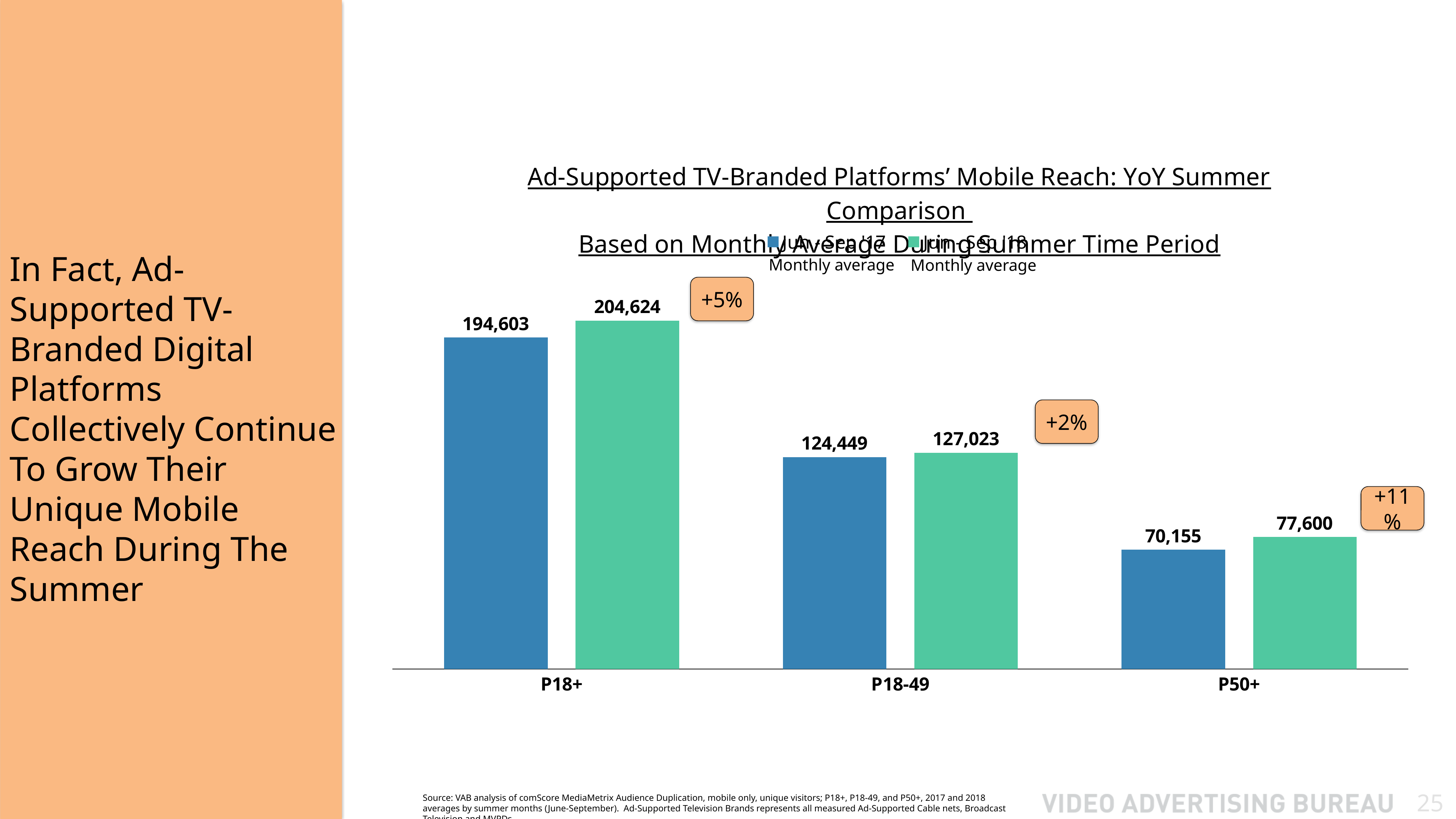
For P18-49, which is larger, the blue bar or the green bar? the green bar What is the difference between the green bar and the blue bar for P50+? 7,445 What is the value of the blue bar for P18+? 194,603 What is the value of the blue bar for P18-49? 124,449 Which category has the highest green bar? P18+ Which category has the lowest blue bar? P50+ What is the value of the green bar for P50+? 77,600 How many age categories are shown on the x axis? 3 What is the difference between the green bar and the blue bar for P18+? 10,021 What percentage change is shown in the callout next to the P50+ bars? +11% What is the value of the green bar for P18+? 204,624 What kind of chart is shown on the slide? bar chart